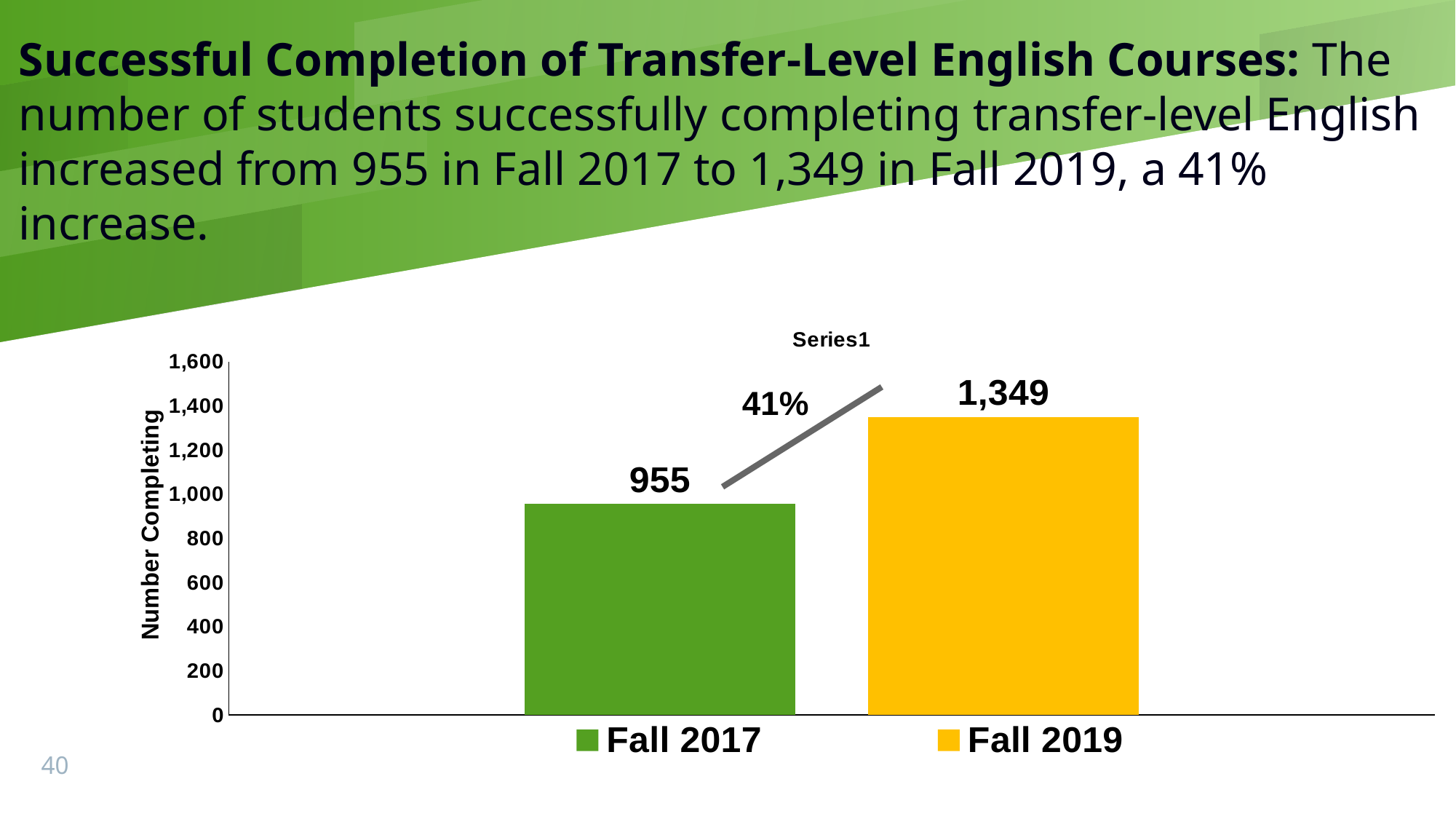
Which is larger, the value for Fall 2017 or the value for Fall 2019? Fall 2019 Which category has the lowest value? Fall 2017 What is the difference between the Fall 2019 and Fall 2017 values? 394 Which category has the highest value? Fall 2019 What is the value for Fall 2017? 955 Is the value for Fall 2019 greater or less than 1,200? greater What is the label on the vertical axis of the chart? Number Completing What is the value for Fall 2019? 1,349 Is the value for Fall 2017 greater or less than 1,000? less What kind of chart is shown on the slide? bar chart How many categories are shown in the chart? 2 Do the values rise or fall from Fall 2017 to Fall 2019? rise